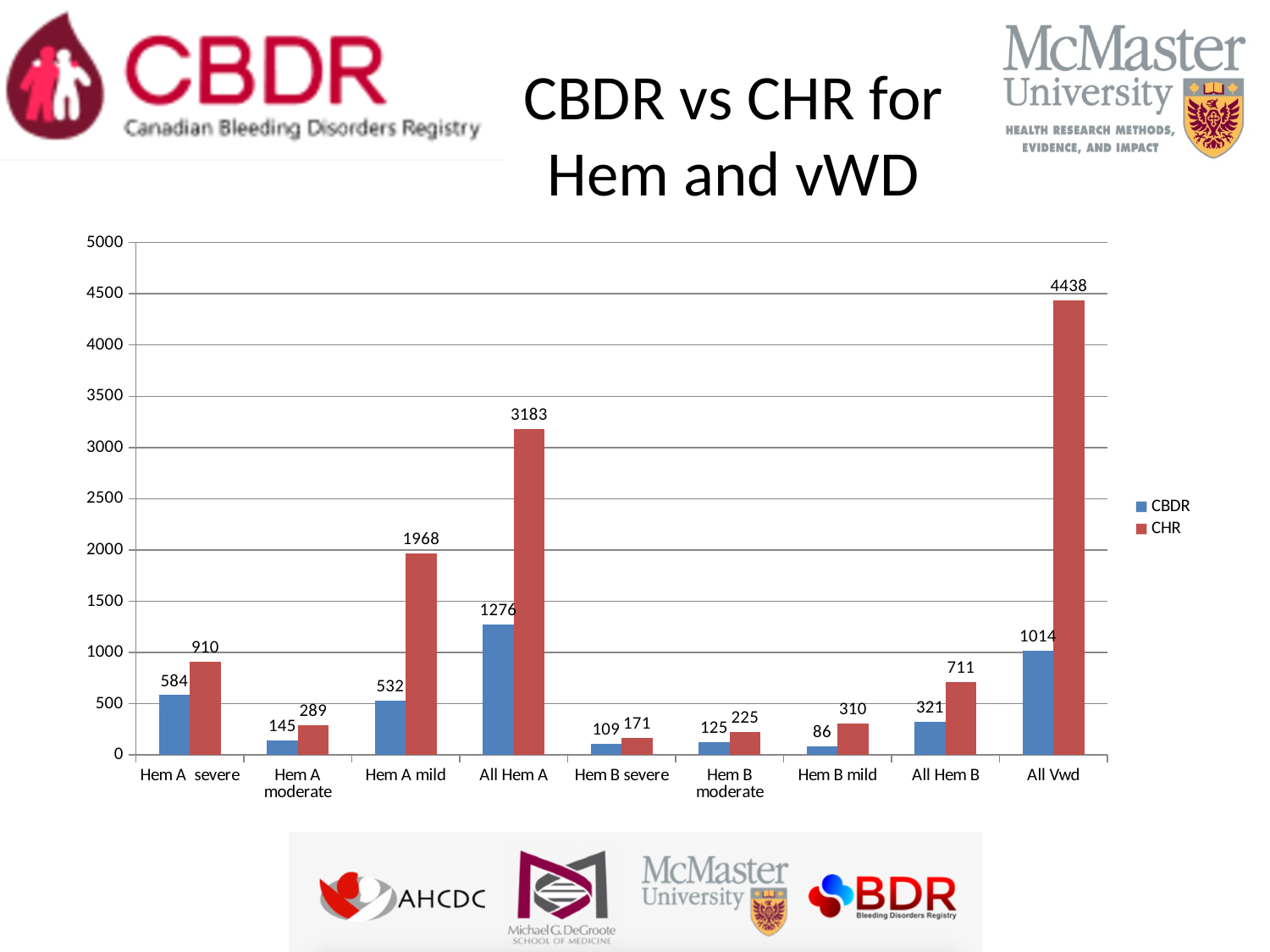
What kind of chart is shown on the slide? bar chart How many categories are shown on the x axis? 9 What is the difference between the CHR and CBDR values for All Hem A? 1907 How many series does the legend list? 2 What is the CHR value for Hem B moderate? 225 What is the CBDR value for Hem A mild? 532 What is the title of the slide? CBDR vs CHR for Hem and vWD Which is larger for Hem A severe, the CBDR value or the CHR value? CHR Is the CHR value for Hem A mild greater or less than 1500? greater Which category has the highest CHR value? All Vwd Which category has the lowest CBDR value? Hem B mild What is the CHR value for All Vwd? 4438